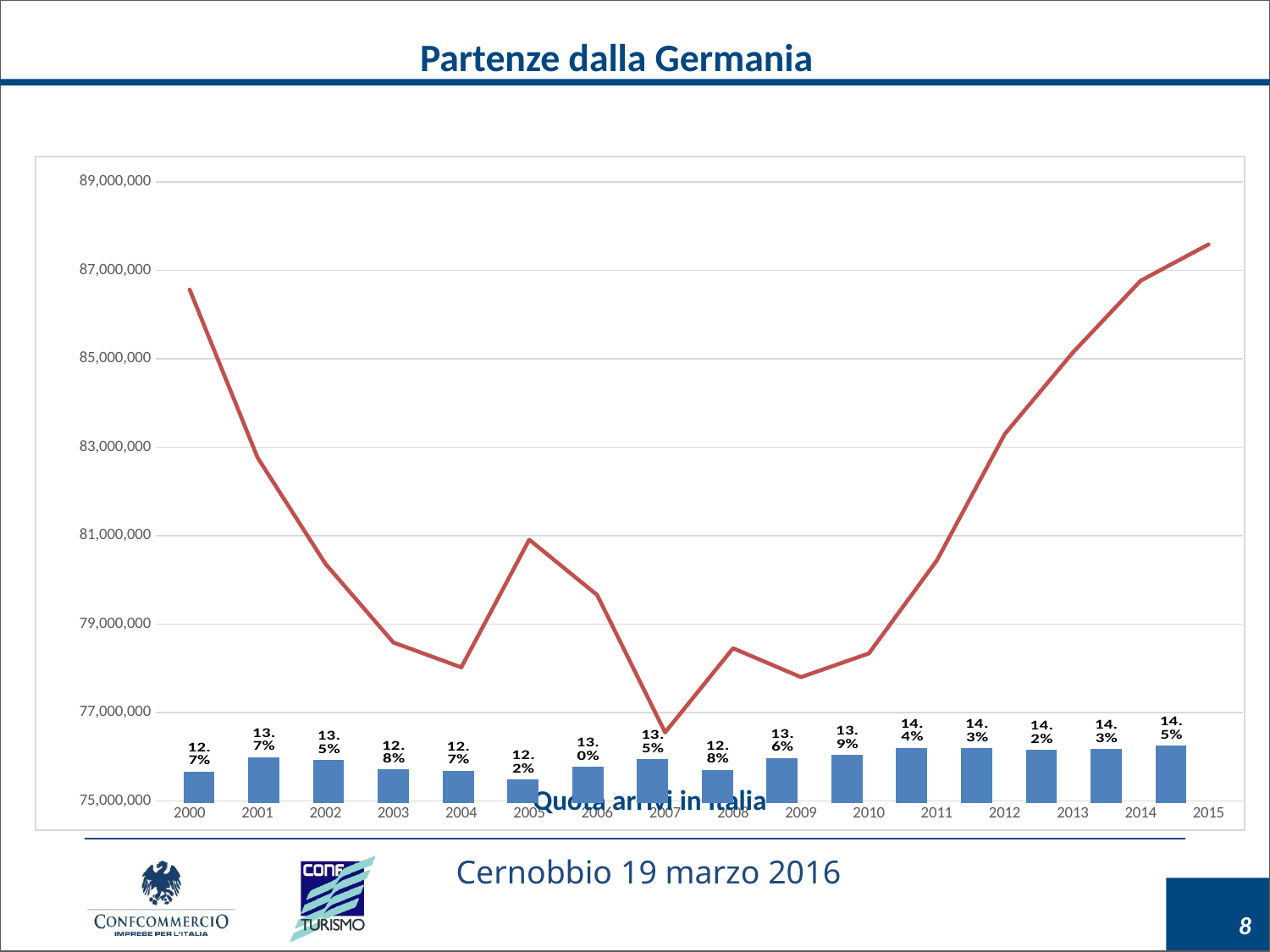
Which is larger, the Quota arrivi in Italia value for 2001 or for 2003? 2001 What is the Quota arrivi in Italia value shown for 2015? 14.5% Which year has the highest Quota arrivi in Italia bar? 2015 How many years are shown on the x axis? 16 Is the value of the red line for 2015 greater or less than 87,000,000? greater Is the value of the red line for 2007 greater or less than 77,000,000? less Is the value of the red line for 2010 greater or less than 79,000,000? less Which year has the lowest Quota arrivi in Italia bar? 2005 Does the red line rise or fall from 2009 to 2015? rises What is the Quota arrivi in Italia value shown for 2011? 14.4% What is the difference between the Quota arrivi in Italia values for 2015 and 2000? 1.8 percentage points What is the Quota arrivi in Italia value shown for 2005? 12.2%